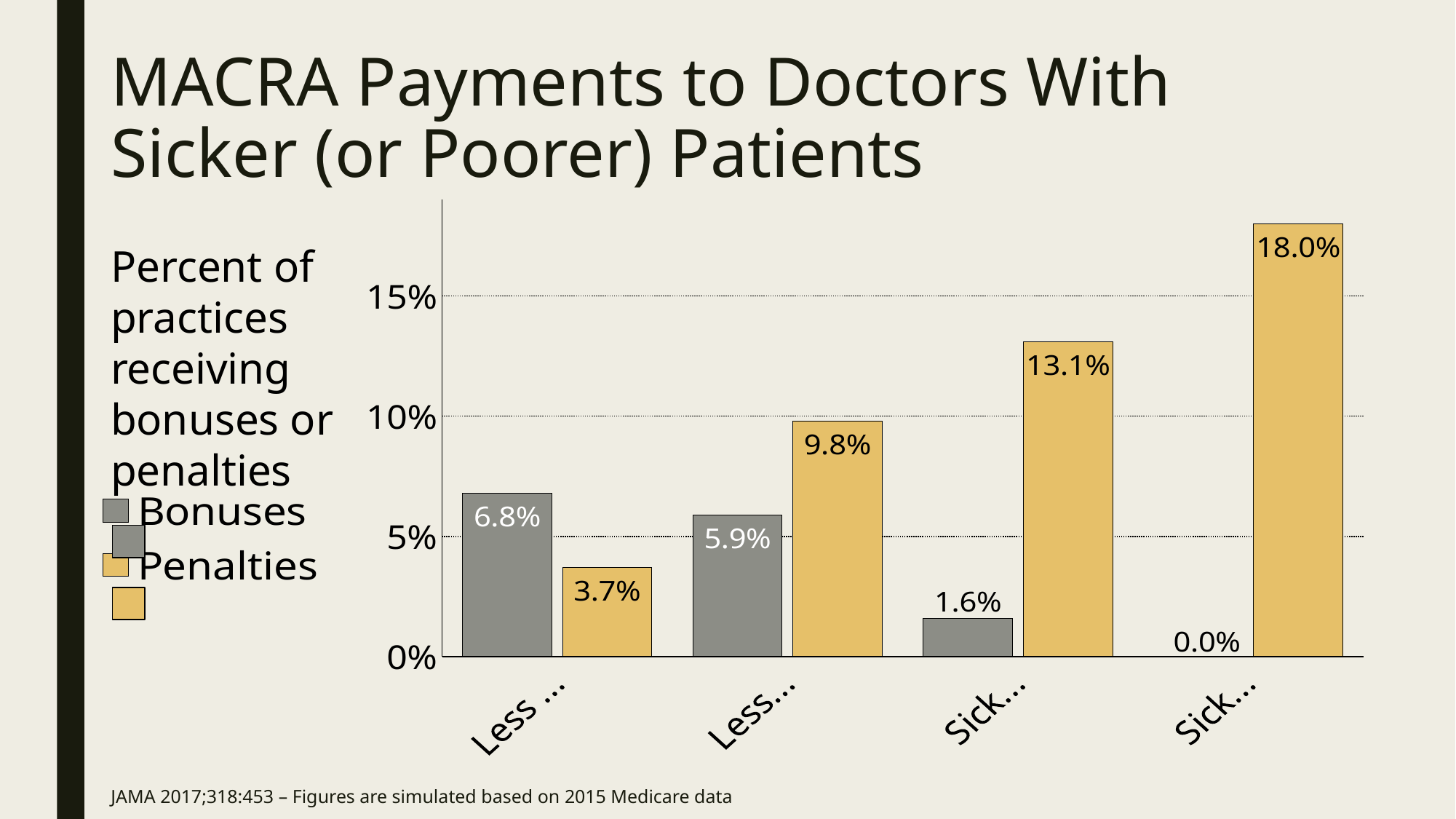
What is the Bonuses value for the first (leftmost) category? 6.8% Which category has the highest Penalties value? The fourth (rightmost) category What is the Penalties value for the second category from the left? 9.8% Do the Penalties values rise or fall moving from left to right across the categories? Rise How many series does the legend list? 2 In the first (leftmost) category, which is larger, the Bonuses value or the Penalties value? Bonuses What is the difference between the Penalties and Bonuses values for the third category from the left? 11.5% What is the Penalties value for the fourth (rightmost) category? 18.0% What is the Bonuses value for the third category from the left? 1.6% Which category has the lowest Bonuses value? The fourth (rightmost) category What type of chart is shown on the slide? Bar chart How many categories are shown along the x axis? 4